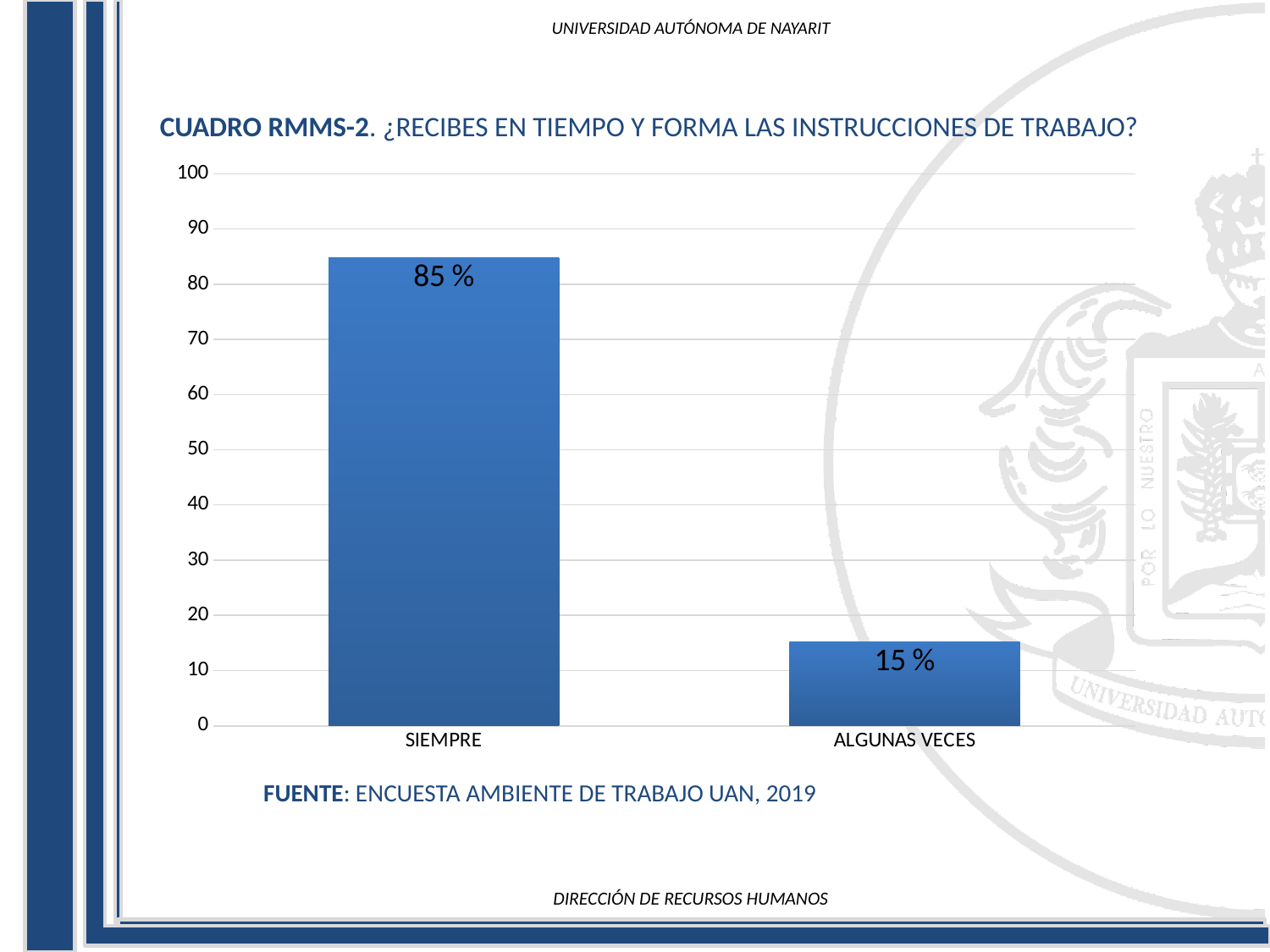
Which is larger, the value for SIEMPRE or the value for ALGUNAS VECES? SIEMPRE Is the value for ALGUNAS VECES greater or less than 20? less What kind of chart is shown on the slide? bar chart What source is cited below the chart? ENCUESTA AMBIENTE DE TRABAJO UAN, 2019 What is the difference between the values for SIEMPRE and ALGUNAS VECES? 70 % What is the value for ALGUNAS VECES? 15 % What is the maximum value shown on the vertical axis? 100 Is the value for SIEMPRE greater or less than 80? greater Which category has the highest value? SIEMPRE How many categories are shown on the x axis? 2 What is the value for SIEMPRE? 85 % Which category has the lowest value? ALGUNAS VECES